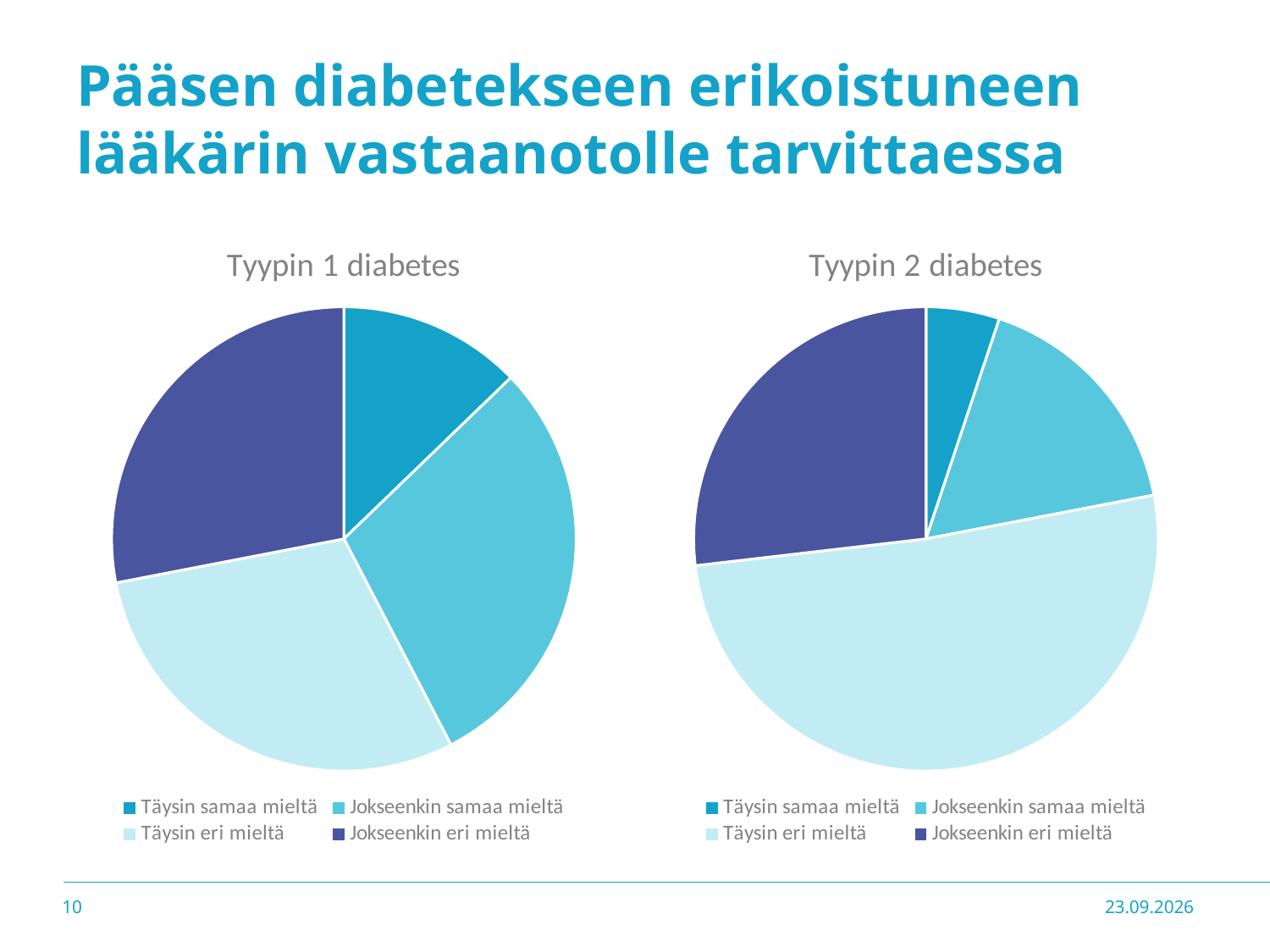
What kind of chart is the "Tyypin 1 diabetes" chart? Pie chart In the "Tyypin 2 diabetes" chart, which category has the largest slice? Täysin eri mieltä In the "Tyypin 2 diabetes" chart, how many entries does the legend list? 4 In the "Tyypin 1 diabetes" chart, how many slices does the pie have? 4 In the "Tyypin 2 diabetes" chart, which slice is larger: "Jokseenkin eri mieltä" or "Jokseenkin samaa mieltä"? Jokseenkin eri mieltä What is the title of the pie chart on the left side of the slide? Tyypin 1 diabetes What kind of chart is the "Tyypin 2 diabetes" chart? Pie chart In the "Tyypin 1 diabetes" chart, which category has the smallest slice? Täysin samaa mieltä In the "Tyypin 1 diabetes" chart, which slice is larger: "Täysin samaa mieltä" or "Jokseenkin samaa mieltä"? Jokseenkin samaa mieltä In the "Tyypin 2 diabetes" chart, which legend entry is shown in the lightest blue colour? Täysin eri mieltä In the "Tyypin 2 diabetes" chart, which slice is larger: "Täysin eri mieltä" or "Jokseenkin eri mieltä"? Täysin eri mieltä In the "Tyypin 2 diabetes" chart, which category has the smallest slice? Täysin samaa mieltä